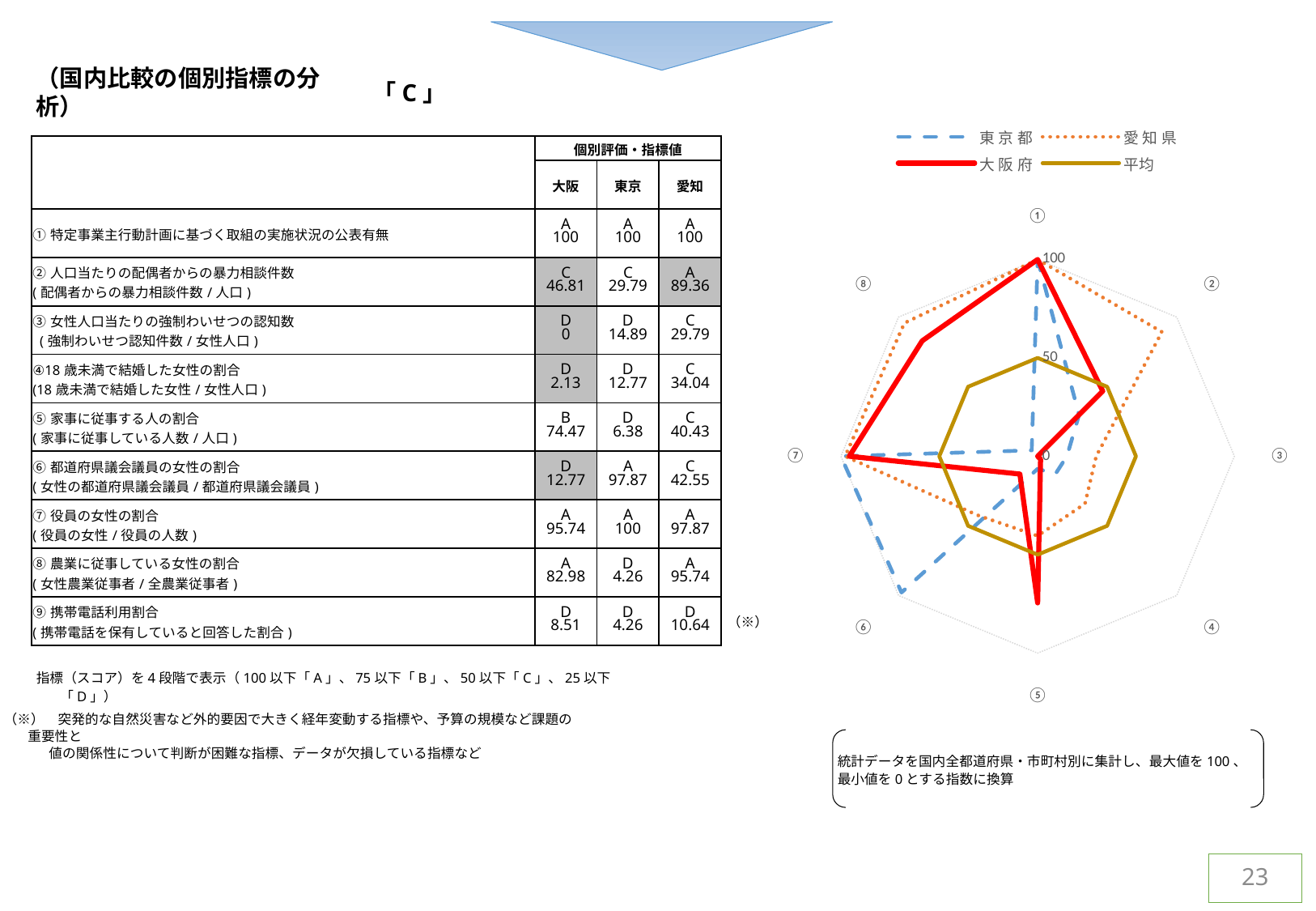
What kind of chart is shown on the right of the slide? radar chart Which series is drawn as a solid red line in the radar chart? 大阪府 Is the value for 大阪府 on axis ⑦ greater or less than 50? greater How many series does the legend of the radar chart list? 4 On axis ⑤, which is larger: the value for 大阪府 or for 東京都? 大阪府 What is the value for 大阪府 on axis ③ in the radar chart? 0 Which series has the lowest value on axis ⑧ of the radar chart? 東京都 How many axes (indicators) does the radar chart have? 8 Is the value for 愛知県 on axis ② greater or less than 50? greater What is the value for 大阪府 on axis ① in the radar chart? 100 Is the value for 東京都 on axis ⑧ greater or less than 50? less Which series has the highest value on axis ⑥ of the radar chart? 東京都